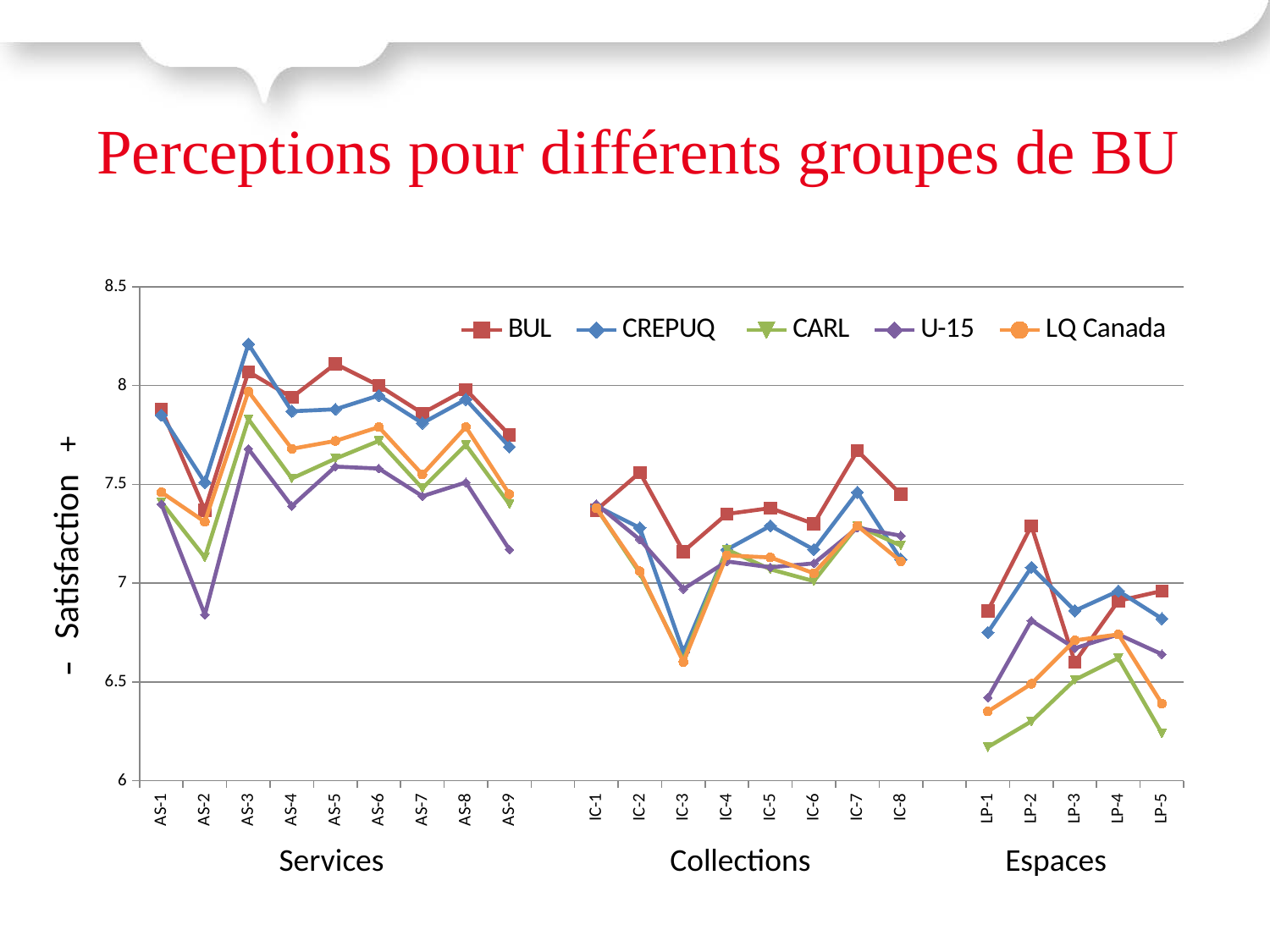
How many categories are plotted along the x axis? 22 What are the three group labels shown below the x axis? Services, Collections, Espaces How many series does the legend list? 5 What kind of chart is shown on the slide? line chart Which is larger for the BUL series: the value at AS-5 or the value at AS-9? AS-5 Is the U-15 value for AS-2 greater or less than 7? less Which series has the highest value at AS-3? CREPUQ At which category does the CREPUQ series reach its highest value? AS-3 Is the CARL value for LP-1 greater or less than 6.5? less Is the BUL value for AS-3 greater or less than 8? greater At which category does the U-15 series reach its lowest value? LP-1